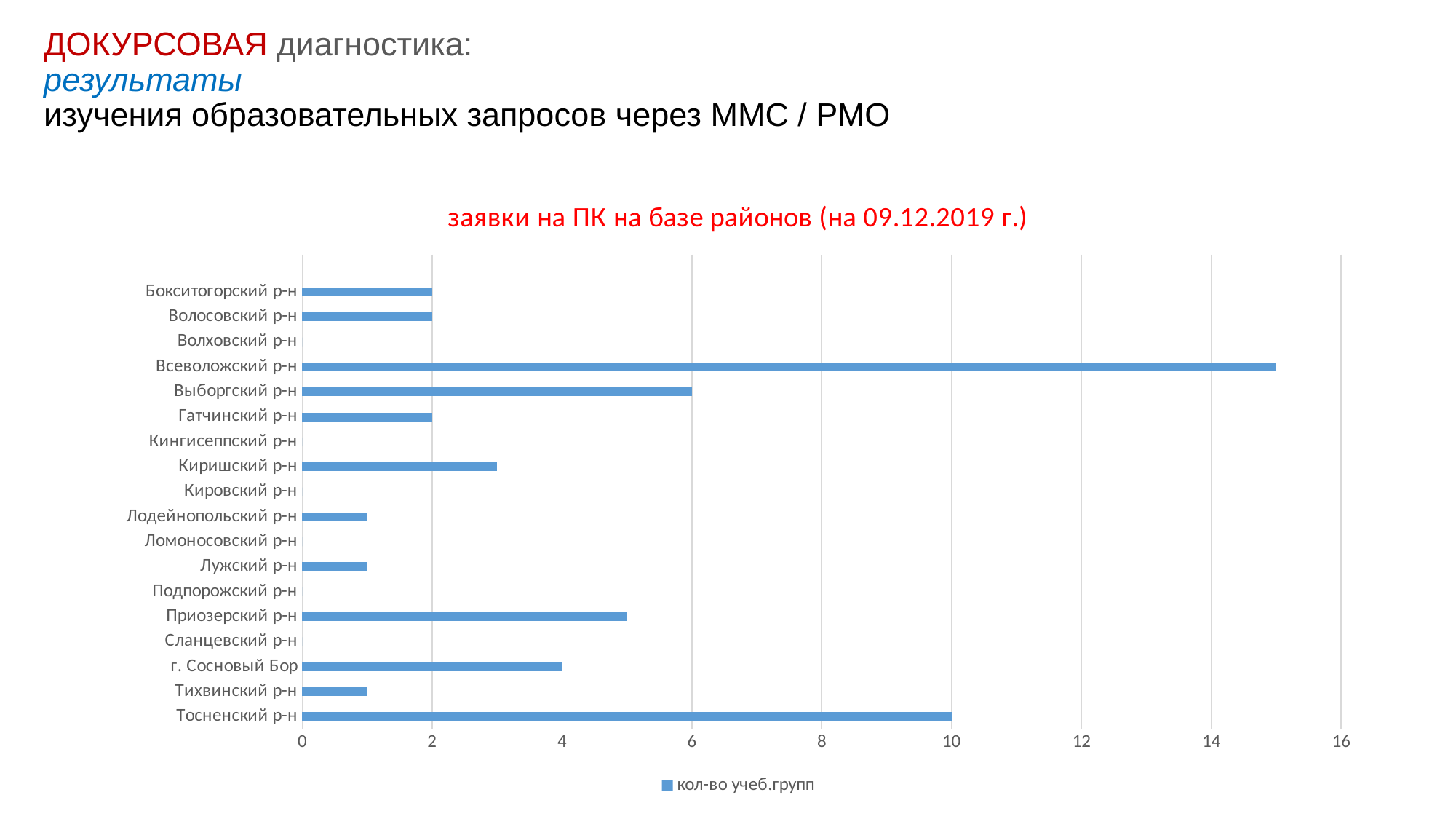
What is the value for Выборгский р-н? 6 Which is larger, the value for Приозерский р-н or the value for Киришский р-н? Приозерский р-н What is the difference between the values for Тосненский р-н and Выборгский р-н? 4 Is the value for Всеволожский р-н greater or less than 14? greater How many districts (categories) are listed on the vertical axis? 18 What is the title of the chart? заявки на ПК на базе районов (на 09.12.2019 г.) What is the value for Тосненский р-н? 10 What is the value for г. Сосновый Бор? 4 What kind of chart is shown on the slide? bar chart How many series does the legend list? 1 Which district has the highest value? Всеволожский р-н What series name does the legend show? кол-во учеб.групп